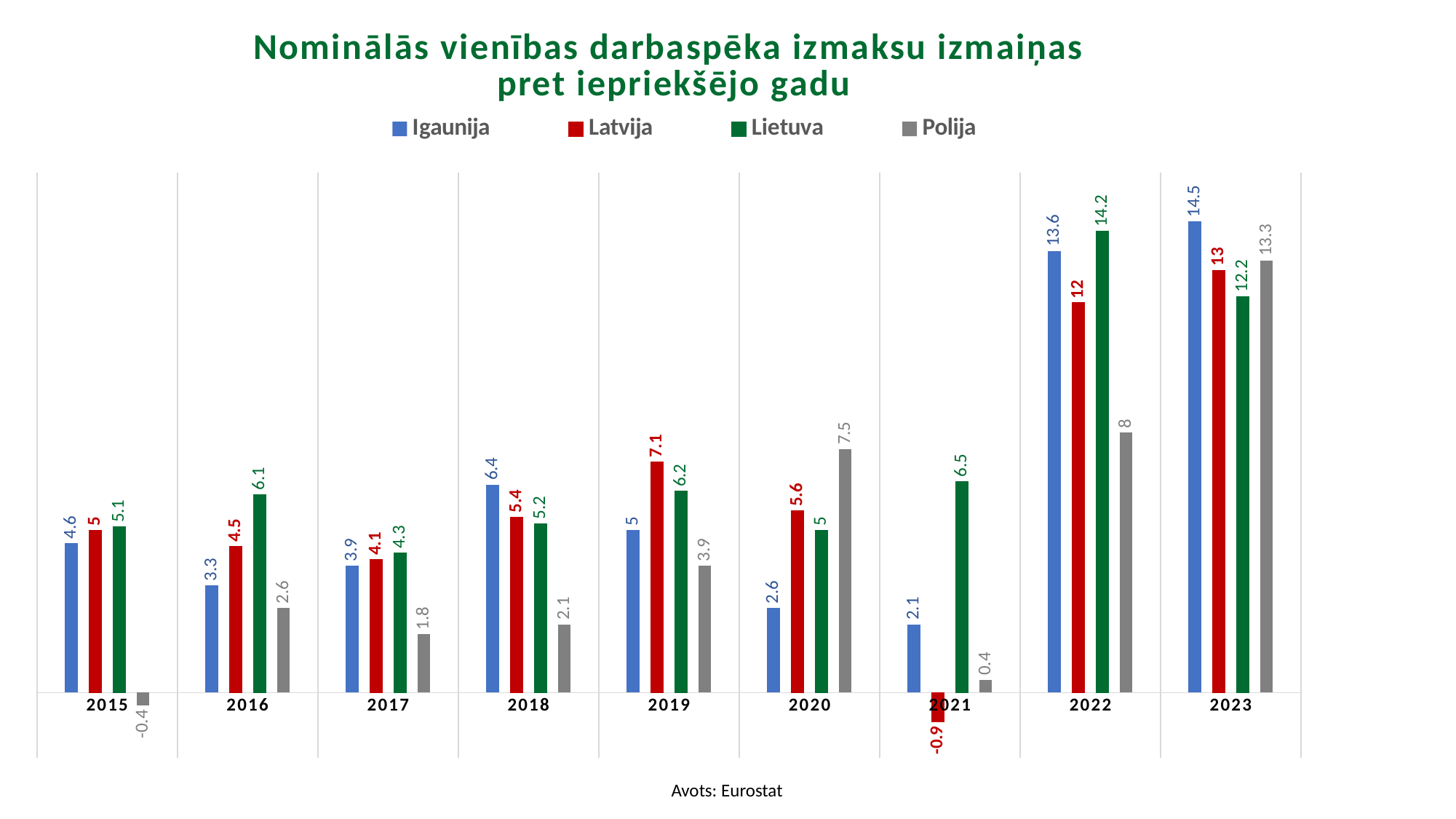
What is the difference between the Igaunija and Polija values in 2022? 5.6 What source is cited below the chart? Eurostat What is the value for Lietuva in 2021? 6.5 Which year has the highest value for Lietuva? 2022 What is the value for Latvija in 2019? 7.1 How many series does the legend list? 4 What kind of chart is shown on the slide? Bar chart What is the value for Igaunija in 2023? 14.5 What is the value for Polija in 2015? -0.4 Which is larger in 2020: the value for Latvija or the value for Polija? Polija How many years are shown on the x axis? 9 Which year has the lowest value for Latvija? 2021